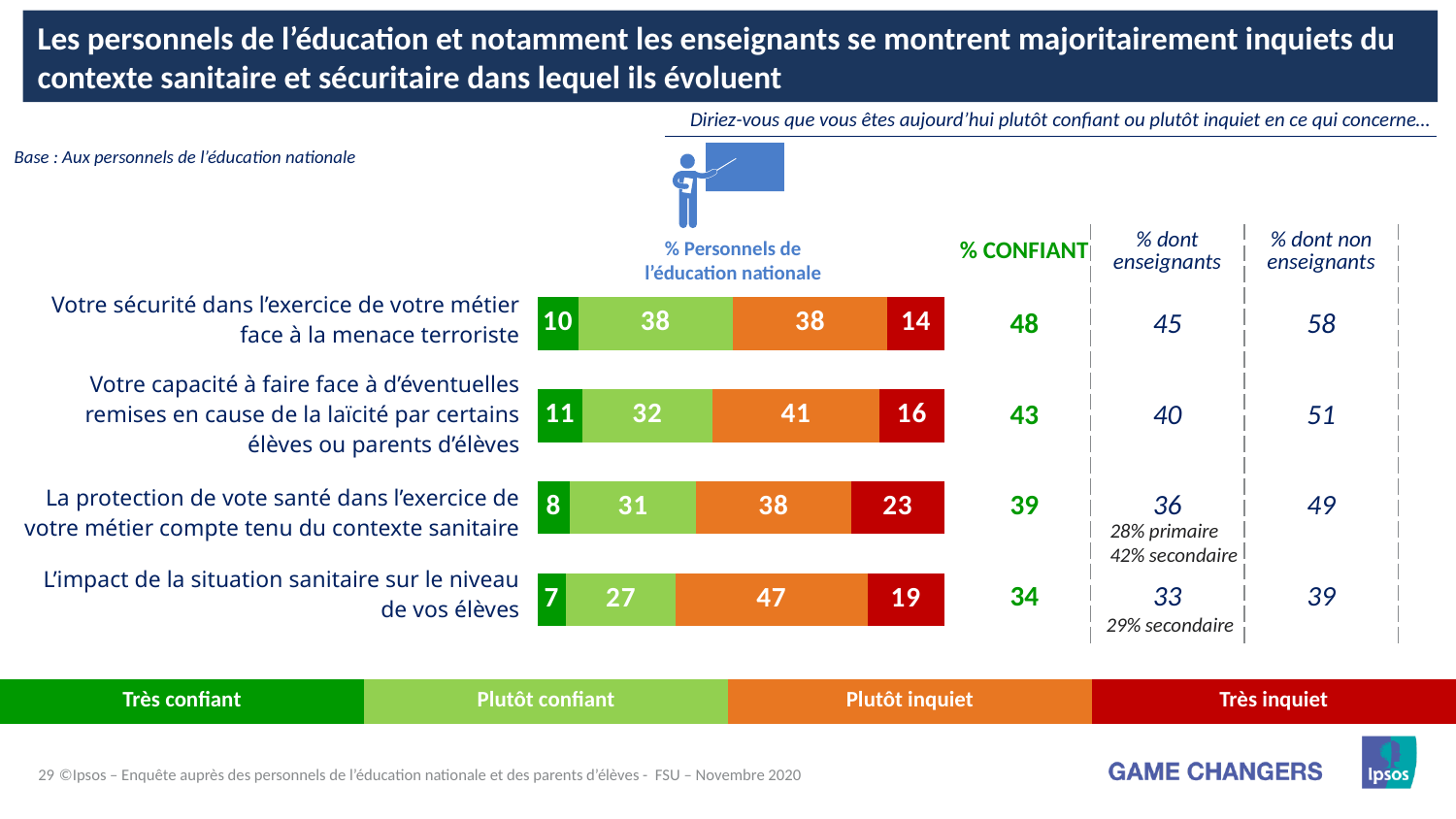
Which has the larger "Plutôt inquiet" value: "Votre capacité à faire face à d'éventuelles remises en cause de la laïcité" or "La protection de vote santé dans l'exercice de votre métier"? Votre capacité à faire face à d'éventuelles remises en cause de la laïcité What is the value for "Plutôt inquiet" for "L'impact de la situation sanitaire sur le niveau de vos élèves"? 47 What is the value for "Très inquiet" for "Votre sécurité dans l'exercice de votre métier face à la menace terroriste"? 14 Which item has the lowest "Très confiant" value? L'impact de la situation sanitaire sur le niveau de vos élèves What is the difference in the "Plutôt confiant" value between "Votre sécurité dans l'exercice de votre métier face à la menace terroriste" and "L'impact de la situation sanitaire sur le niveau de vos élèves"? 11 What is the "% CONFIANT" value for "La protection de vote santé dans l'exercice de votre métier compte tenu du contexte sanitaire"? 39 How many series does the legend list? 4 What kind of chart is shown on the slide? Stacked bar chart What is the combined total of "Très confiant" and "Plutôt confiant" for "Votre capacité à faire face à d'éventuelles remises en cause de la laïcité"? 43 What colour represents "Très inquiet" in the legend? Red Which item has the highest "Très inquiet" value? La protection de vote santé dans l'exercice de votre métier compte tenu du contexte sanitaire How many items (bars) are shown in the chart? 4